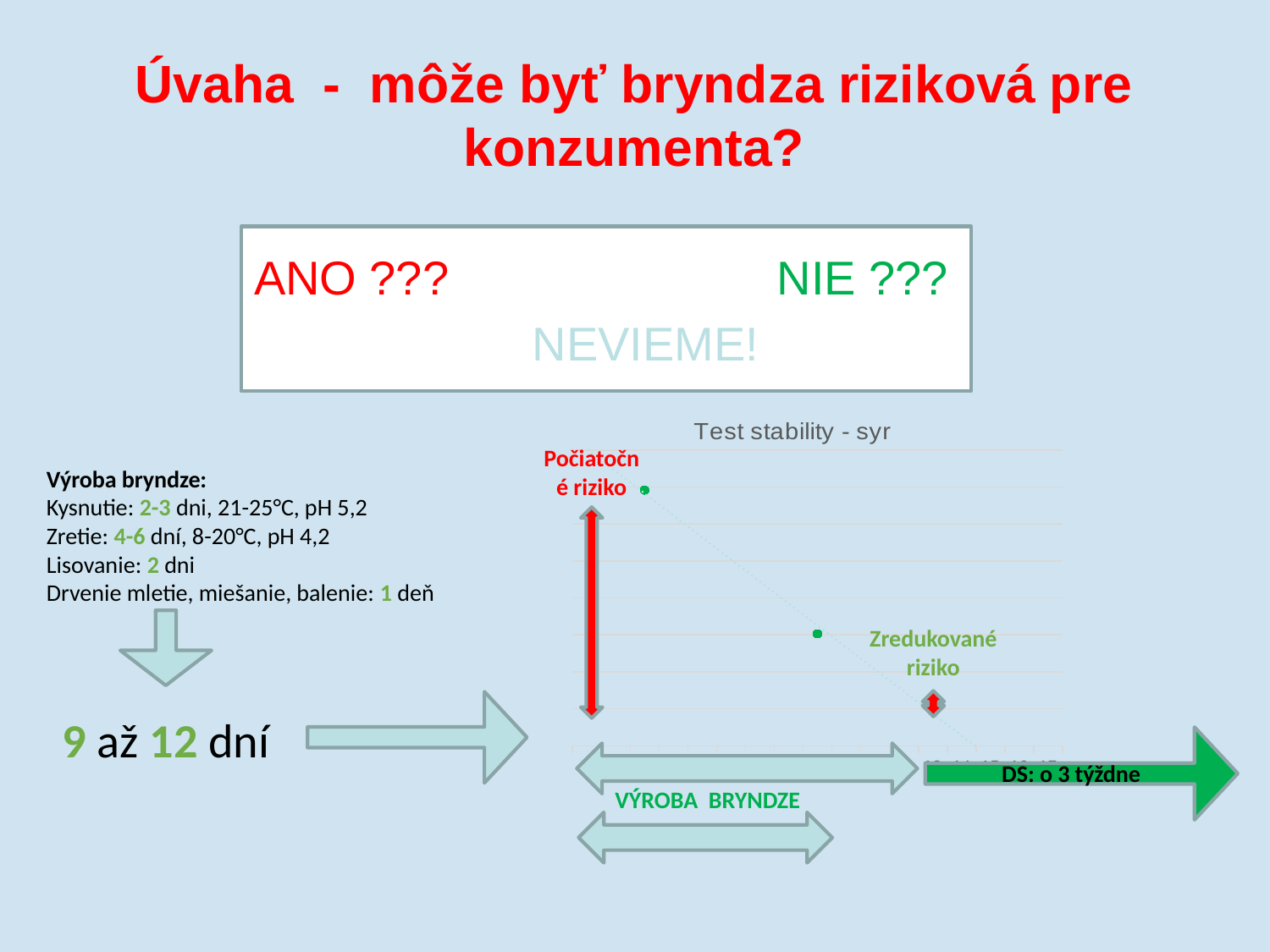
In the chart 'Test stability - syr', do the plotted values rise or fall from left to right? fall In the chart 'Test stability - syr', how many data points are plotted? 3 In the chart 'Test stability - syr', which plotted point is the lowest: the first (leftmost) or the last (rightmost)? the last (rightmost) In the chart 'Test stability - syr', which plotted point is the highest: the first (leftmost) or the last (rightmost)? the first (leftmost) In the chart 'Test stability - syr', is the first plotted point higher or lower than the last plotted point? higher In the chart 'Test stability - syr', what label is placed next to the first (highest) data point? Počiatočné riziko What is the title of the chart on the slide? Test stability - syr